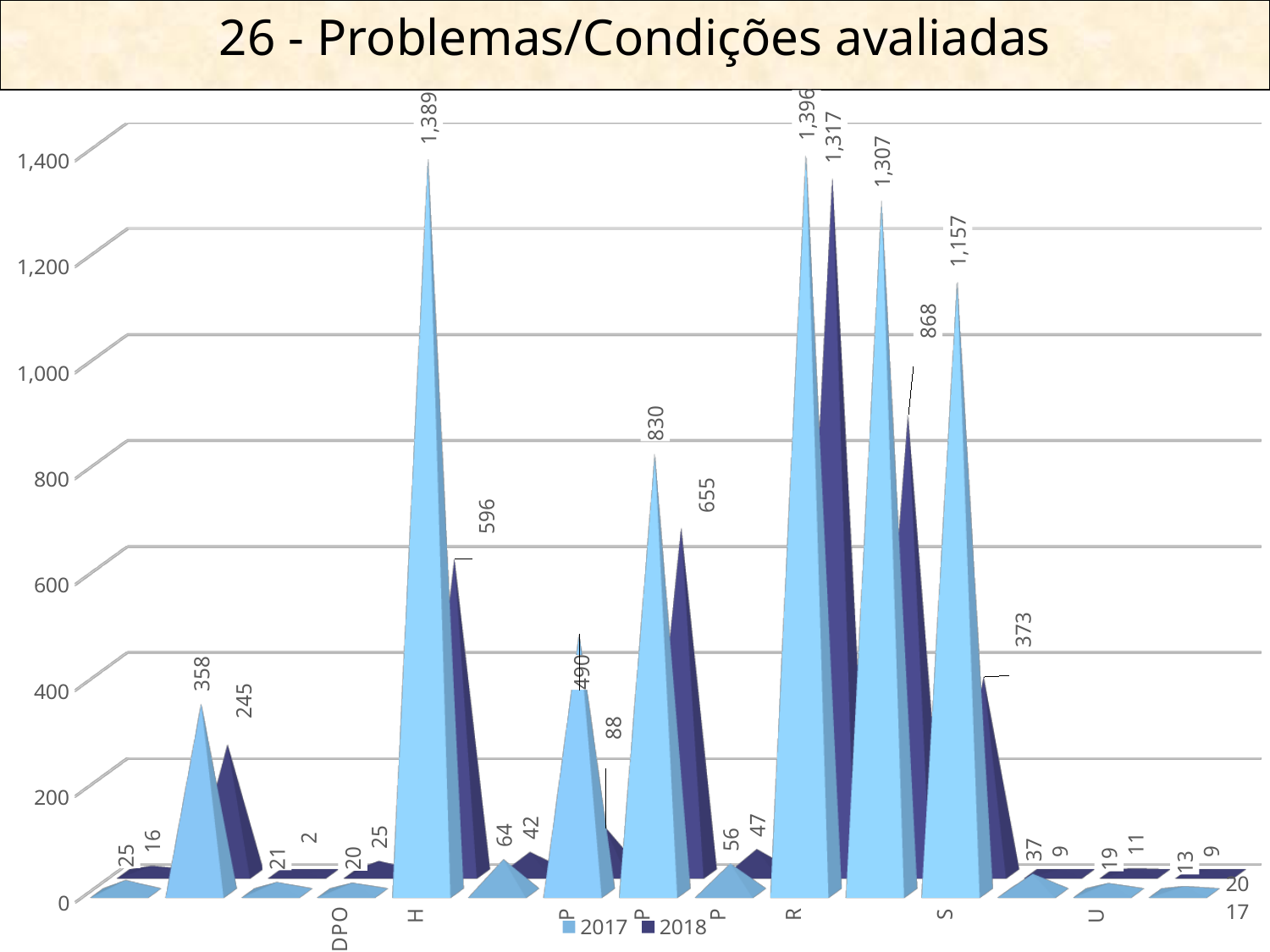
In the category where the 2017 value is 1,389, what is the 2018 value? 596 What is the highest value plotted for the 2018 series? 1,317 What is the lowest value plotted for the 2018 series? 2 What is the difference between the highest 2017 value (1,396) and the highest 2018 value (1,317)? 79 What is the highest tick value shown on the vertical axis? 1,400 In the category where the 2017 value is 1,157, is the 2018 value greater or less than 400? less What is the highest value plotted for the 2017 series? 1,396 What is the title of the chart? 26 - Problemas/Condições avaliadas What are the two series named in the legend? 2017 and 2018 How many categories are plotted on the x axis? 15 How many series does the legend list? 2 What is the lowest value plotted for the 2017 series? 13